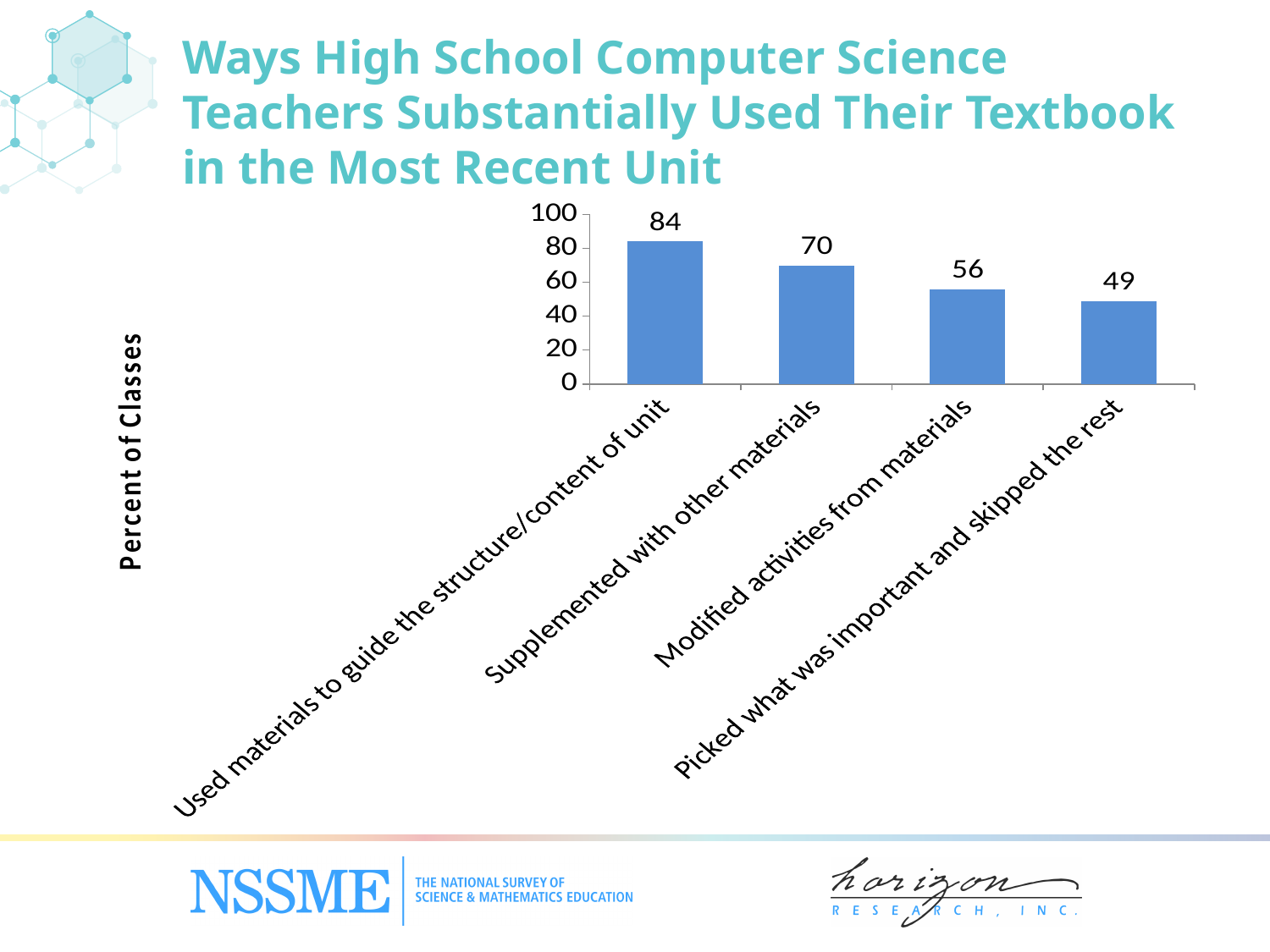
Which is larger, the value for 'Supplemented with other materials' or 'Modified activities from materials'? Supplemented with other materials What is the value for 'Used materials to guide the structure/content of unit'? 84 What is the value for 'Picked what was important and skipped the rest'? 49 Which category has the lowest value? Picked what was important and skipped the rest How many categories are shown in the chart? 4 Do the values rise or fall from left to right along the x axis? Fall What kind of chart is shown on the slide? Bar chart What is the value for 'Modified activities from materials'? 56 What is the difference between the values for 'Used materials to guide the structure/content of unit' and 'Picked what was important and skipped the rest'? 35 What is the value for 'Supplemented with other materials'? 70 Which category has the highest value? Used materials to guide the structure/content of unit What is the difference between the values for 'Supplemented with other materials' and 'Modified activities from materials'? 14